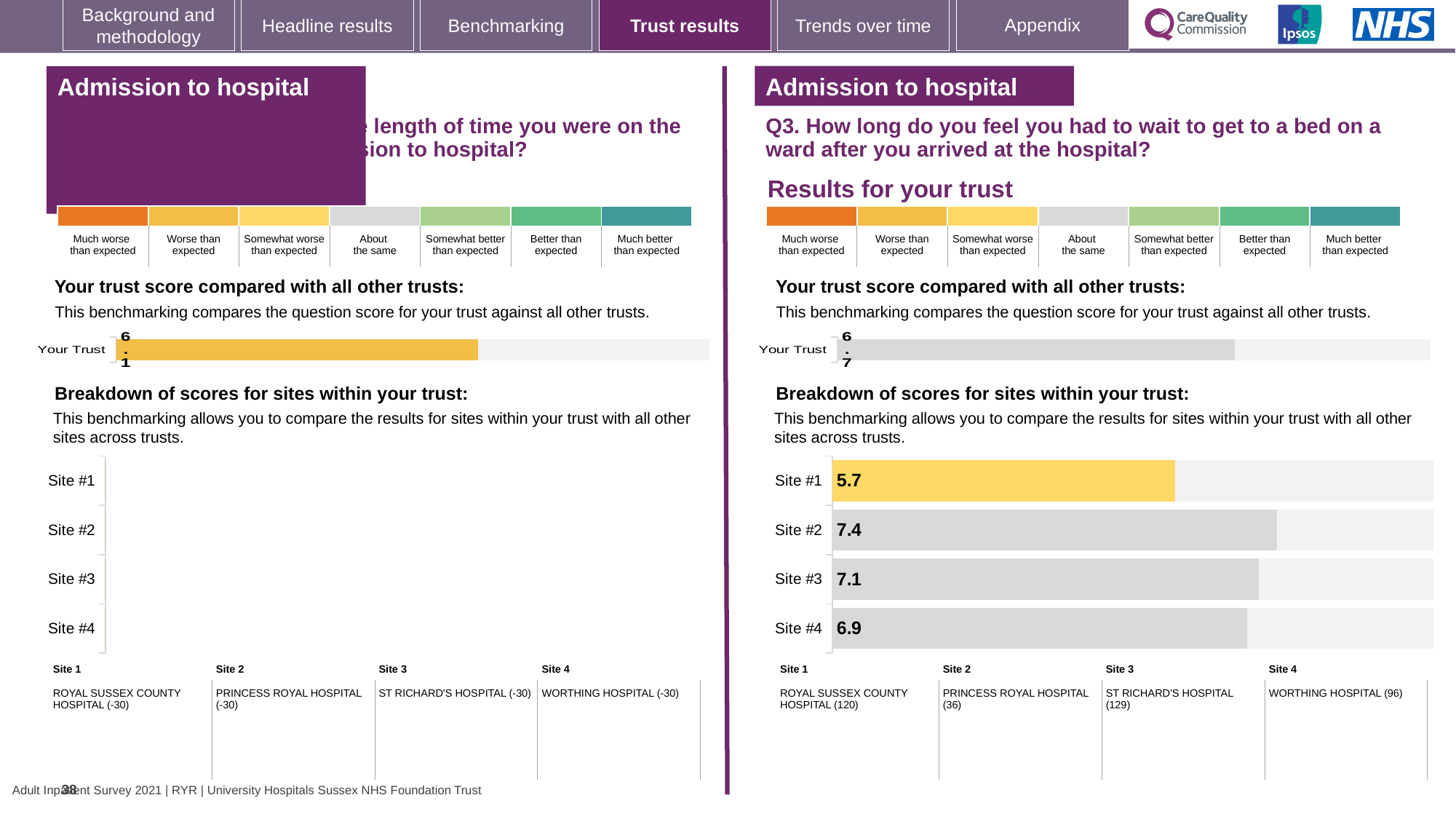
On the right-hand site breakdown chart (Q3), what is the score for Site #2? 7.4 On the left-hand 'Your trust score compared with all other trusts' chart, what is the score for Your Trust? 6.1 On the right-hand site breakdown chart (Q3), which site has the highest score? Site #2 On the right-hand site breakdown chart (Q3), what is the score for Site #4? 6.9 On the right-hand site breakdown chart (Q3), which has the higher score, Site #3 or Site #4? Site #3 On the right-hand 'Breakdown of scores for sites within your trust' chart (Q3), what is the score for Site #1? 5.7 On the right-hand site breakdown chart (Q3), what is the difference between the scores for Site #2 and Site #1? 1.7 How many sites are shown on the right-hand site breakdown chart (Q3)? 4 On the right-hand site breakdown chart (Q3), what is the difference between the scores for Site #3 and Site #4? 0.2 On the right-hand 'Your trust score compared with all other trusts' chart (Q3), what is the score for Your Trust? 6.7 What type of chart is the right-hand site breakdown chart (Q3)? Bar chart On the right-hand site breakdown chart (Q3), which site has the lowest score? Site #1